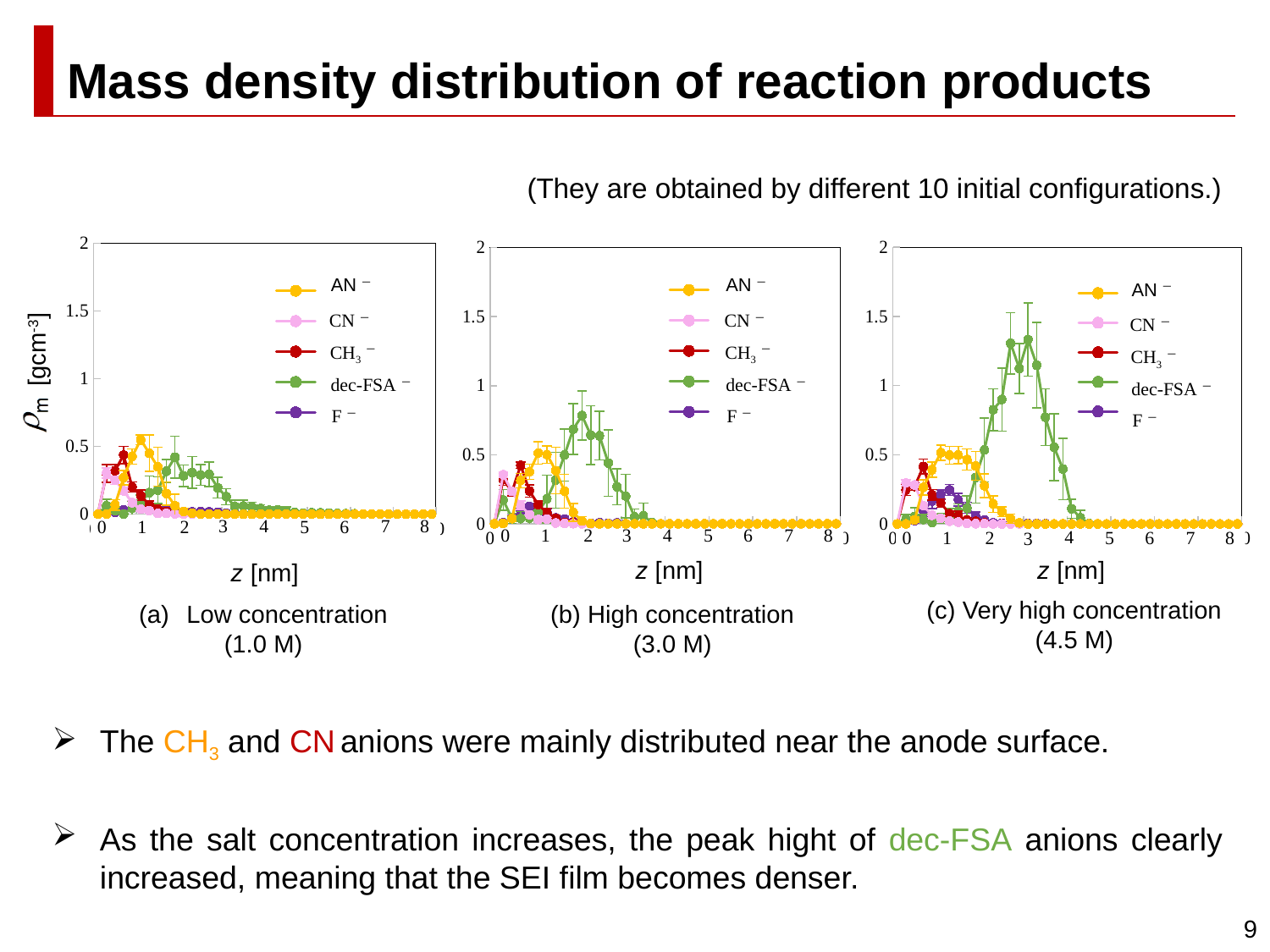
In chart (c) Very high concentration (4.5 M), which series reaches the highest peak value? dec-FSA⁻ In chart (c) Very high concentration (4.5 M), which series has the higher peak: dec-FSA⁻ or AN⁻? dec-FSA⁻ How many charts are shown on the slide? 3 What is the label of the x axis on the charts? z [nm] In chart (c) Very high concentration (4.5 M), is the peak value of the dec-FSA⁻ series greater or less than 1? greater What kind of chart is chart (a) Low concentration (1.0 M)? line chart In chart (c) Very high concentration (4.5 M), how many series does the legend list? 5 In chart (b) High concentration (3.0 M), is the peak value of the dec-FSA⁻ series greater or less than 1? less In chart (b) High concentration (3.0 M), is the peak value of the dec-FSA⁻ series greater or less than 0.5? greater What is the title of the slide containing the charts? Mass density distribution of reaction products In chart (b) High concentration (3.0 M), which series has the higher peak: dec-FSA⁻ or F⁻? dec-FSA⁻